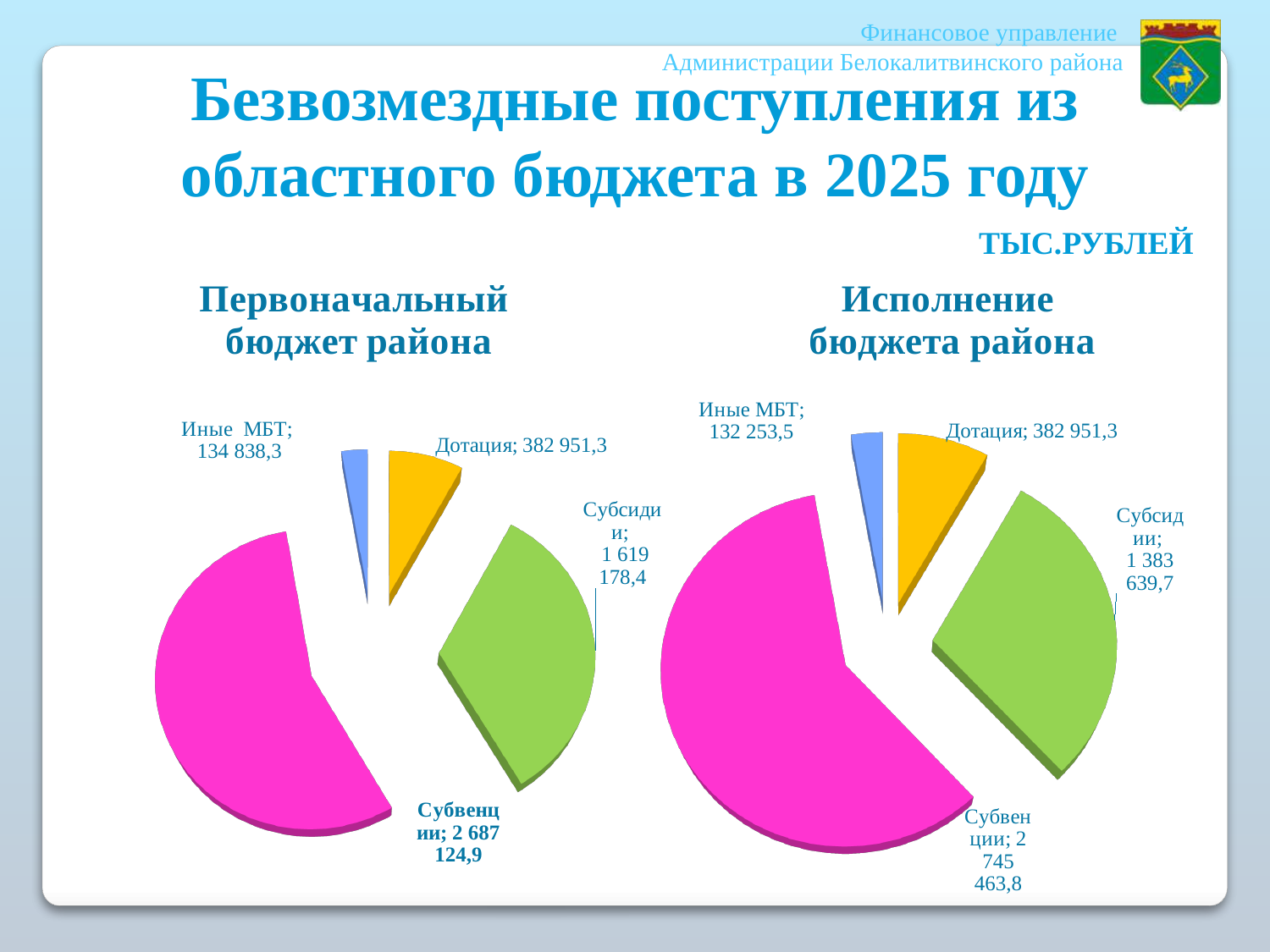
Which is larger: Иные МБТ in the «Первоначальный бюджет района» chart or Иные МБТ in the «Исполнение бюджета района» chart? Первоначальный бюджет района In the chart titled «Исполнение бюджета района», which category has the smallest value? Иные МБТ In the chart titled «Первоначальный бюджет района», which category has the largest value? Субвенции What kind of chart is the one titled «Первоначальный бюджет района»? Pie chart What is the difference between the Субсидии value in the «Первоначальный бюджет района» chart and the Субсидии value in the «Исполнение бюджета района» chart? 235 538,7 In the chart titled «Исполнение бюджета района», what is the value for Субсидии? 1 383 639,7 In the chart titled «Первоначальный бюджет района», what is the value for Дотация? 382 951,3 What is the difference between the Субвенции value in the «Исполнение бюджета района» chart and the Субвенции value in the «Первоначальный бюджет района» chart? 58 338,9 In what units are the values on the slide given? ТЫС.РУБЛЕЙ In the chart titled «Исполнение бюджета района», what is the value for Субвенции? 2 745 463,8 In the chart titled «Первоначальный бюджет района», what is the value for Иные МБТ? 134 838,3 How many categories does the chart titled «Исполнение бюджета района» show? 4